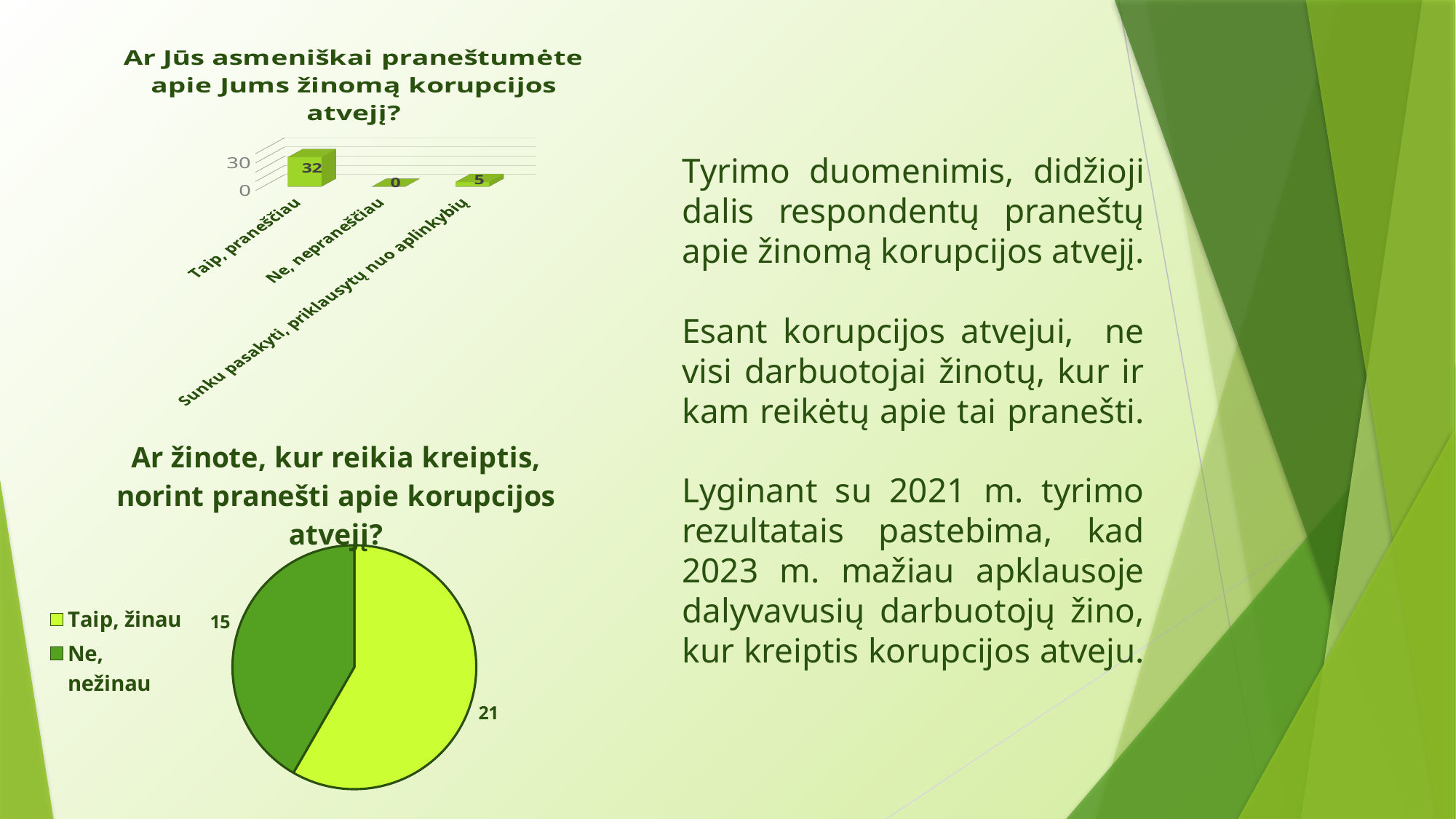
In the top chart 'Ar Jūs asmeniškai praneštumėte apie Jums žinomą korupcijos atvejį?', what is the value for 'Sunku pasakyti, priklausytų nuo aplinkybių'? 5 How many categories does the top bar chart 'Ar Jūs asmeniškai praneštumėte apie Jums žinomą korupcijos atvejį?' show? 3 In the top chart 'Ar Jūs asmeniškai praneštumėte apie Jums žinomą korupcijos atvejį?', which category has the highest value? Taip, praneščiau How many entries does the legend of the bottom pie chart 'Ar žinote, kur reikia kreiptis, norint pranešti apie korupcijos atvejį?' list? 2 What kind of chart is the top chart 'Ar Jūs asmeniškai praneštumėte apie Jums žinomą korupcijos atvejį?'? Bar chart In the top chart 'Ar Jūs asmeniškai praneštumėte apie Jums žinomą korupcijos atvejį?', what is the value for 'Taip, praneščiau'? 32 In the bottom pie chart 'Ar žinote, kur reikia kreiptis, norint pranešti apie korupcijos atvejį?', what is the value for 'Taip, žinau'? 21 In the bottom pie chart 'Ar žinote, kur reikia kreiptis, norint pranešti apie korupcijos atvejį?', which is larger, 'Taip, žinau' or 'Ne, nežinau'? Taip, žinau In the top chart 'Ar Jūs asmeniškai praneštumėte apie Jums žinomą korupcijos atvejį?', what is the difference between 'Taip, praneščiau' and 'Sunku pasakyti, priklausytų nuo aplinkybių'? 27 In the bottom pie chart 'Ar žinote, kur reikia kreiptis, norint pranešti apie korupcijos atvejį?', what is the value for 'Ne, nežinau'? 15 In the top chart 'Ar Jūs asmeniškai praneštumėte apie Jums žinomą korupcijos atvejį?', which category has the lowest value? Ne, nepraneščiau In the top chart 'Ar Jūs asmeniškai praneštumėte apie Jums žinomą korupcijos atvejį?', what is the value for 'Ne, nepraneščiau'? 0